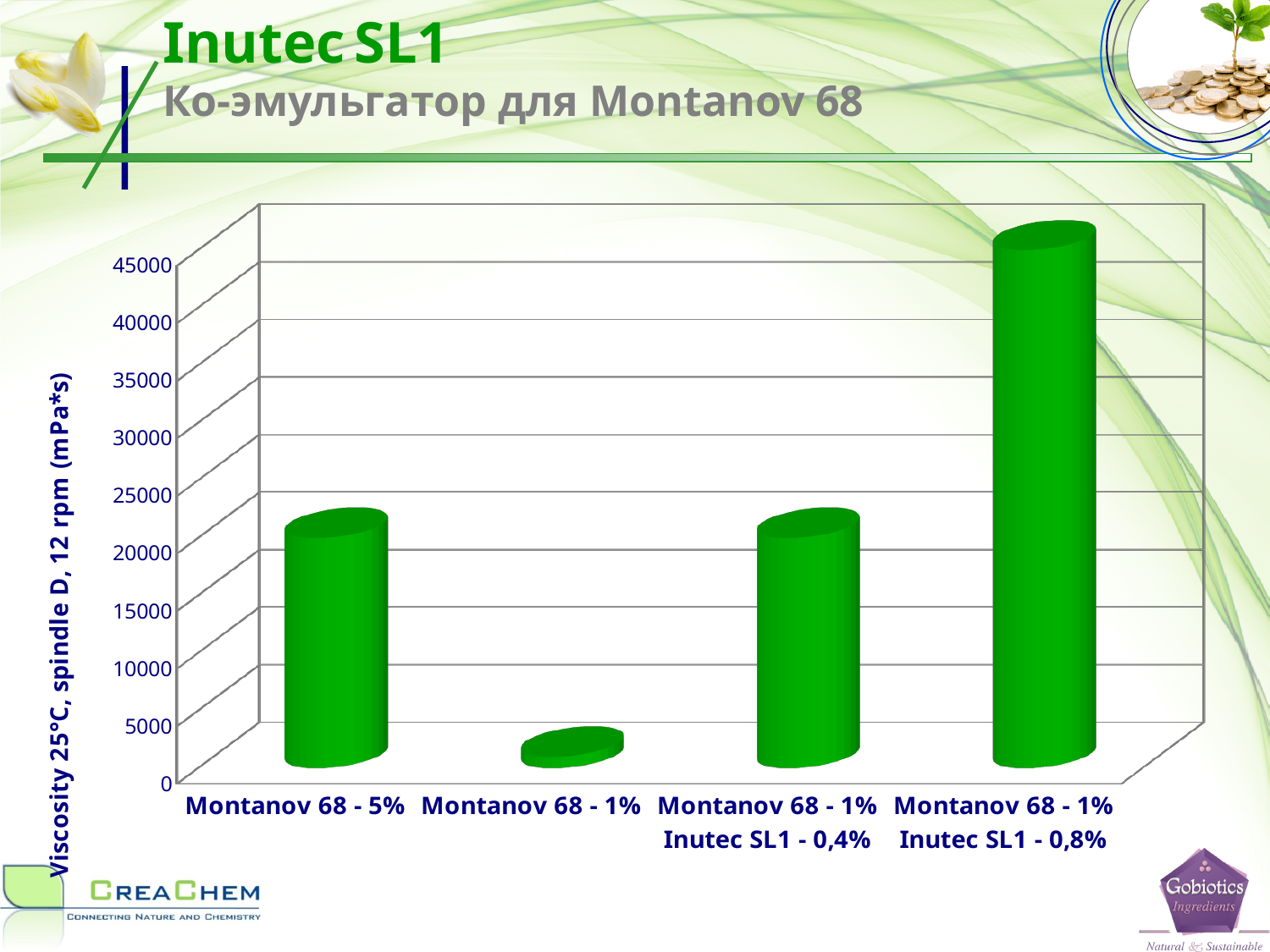
Which has the higher viscosity: Montanov 68 - 5% or Montanov 68 - 1% Inutec SL1 - 0,8%? Montanov 68 - 1% Inutec SL1 - 0,8% What kind of chart is shown on the slide? bar chart Which has the higher viscosity: Montanov 68 - 1% or Montanov 68 - 1% Inutec SL1 - 0,4%? Montanov 68 - 1% Inutec SL1 - 0,4% What is the highest value labelled on the vertical axis of the chart? 45000 Which category has the highest viscosity in the chart? Montanov 68 - 1% Inutec SL1 - 0,8% Is the viscosity for Montanov 68 - 1% Inutec SL1 - 0,4% greater or less than 15000? greater Is the viscosity for Montanov 68 - 5% greater or less than 15000? greater Is the viscosity for Montanov 68 - 1% greater or less than 5000? less What is the title of the vertical axis of the chart? Viscosity 25°C, spindle D, 12 rpm (mPa*s) Which category has the lowest viscosity in the chart? Montanov 68 - 1% How many bars (categories) are plotted in the chart? 4